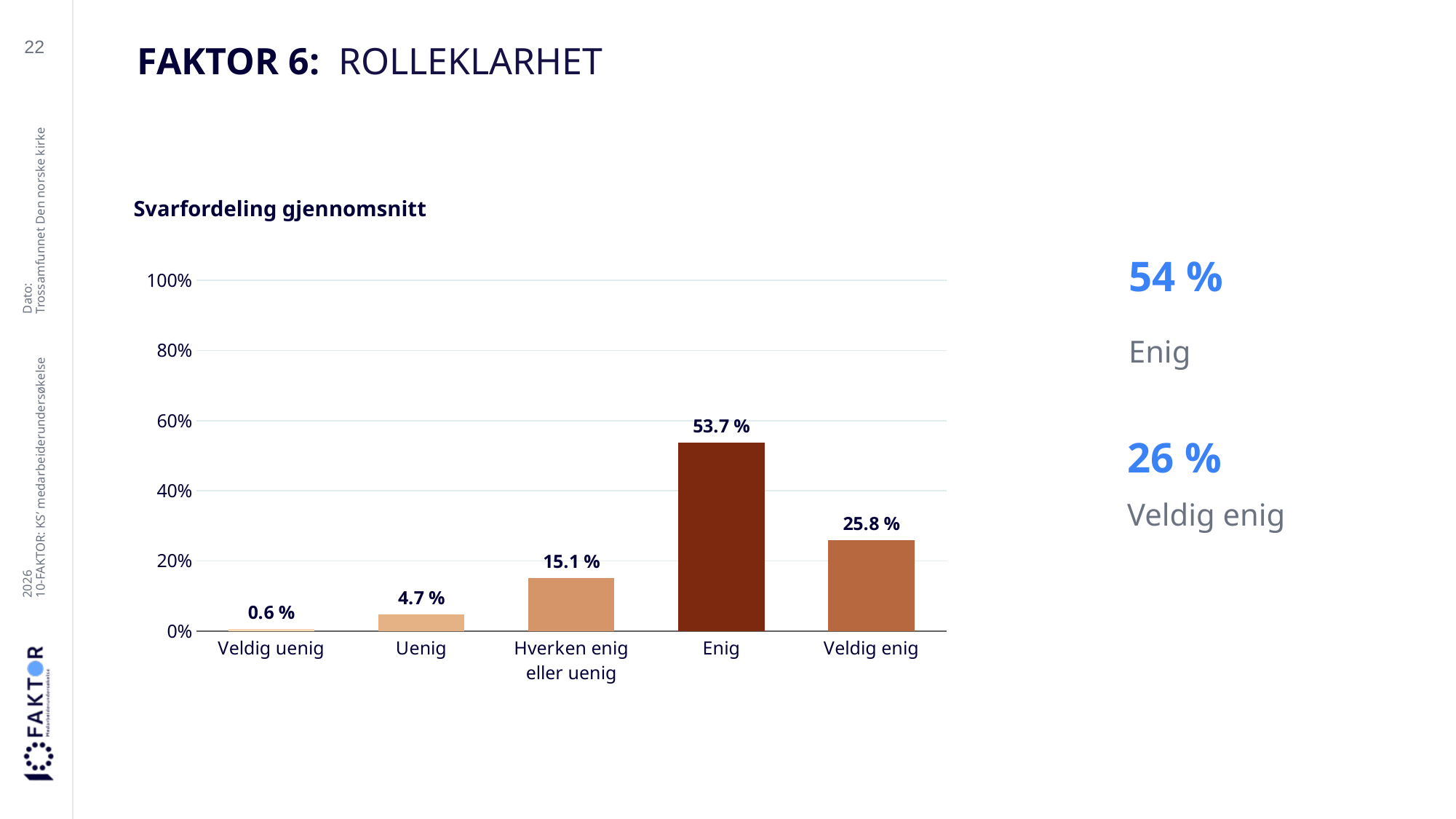
What is the title of the chart? Svarfordeling gjennomsnitt Is the value for Veldig enig greater or less than 40%? less What kind of chart is shown? bar chart Which is larger, the value for Uenig or the value for Hverken enig eller uenig? Hverken enig eller uenig What is the value for Hverken enig eller uenig? 15.1 % What is the value for Veldig uenig? 0.6 % Which category has the highest value? Enig What is the difference between the values for Enig and Veldig enig? 27.9 % Which category has the lowest value? Veldig uenig What is the difference between the values for Uenig and Veldig uenig? 4.1 % How many categories are shown on the x axis? 5 What is the value for Enig? 53.7 %